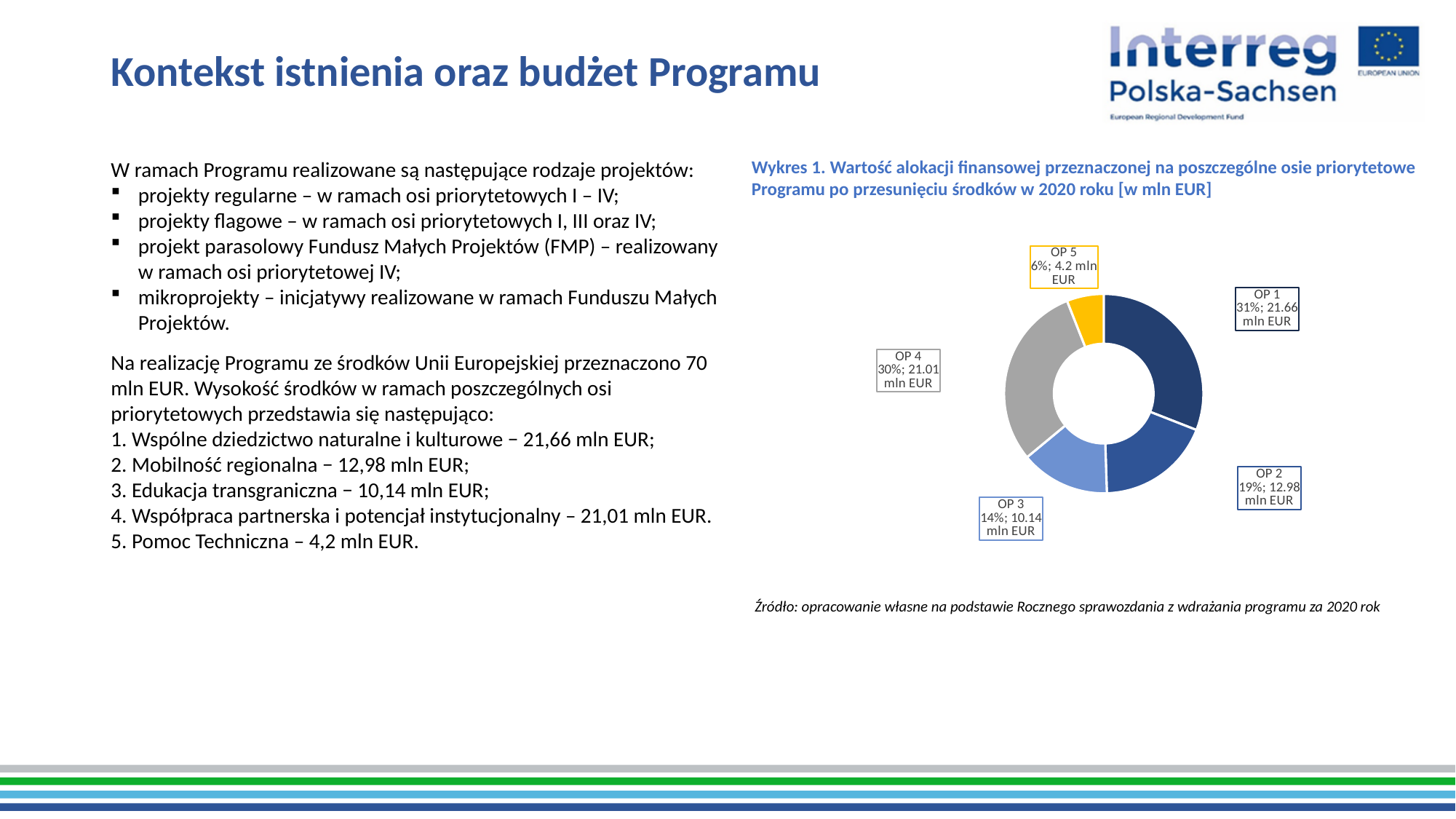
How many slices does the doughnut chart have? 5 What is the value for OP 1 in the chart? 21.66 mln EUR Which slice has the smallest value? OP 5 Which is larger, the value for OP 2 or the value for OP 5? OP 2 What share of the total does OP 4 represent? 30% What kind of chart is shown on the slide? doughnut chart What colour is the OP 5 slice? yellow What is the value for OP 3 in the chart? 10.14 mln EUR What is the value for OP 5 in the chart? 4.2 mln EUR Which slice has the largest value? OP 1 What is the difference between the values for OP 2 and OP 3? 2.84 mln EUR What share of the total does OP 2 represent? 19%